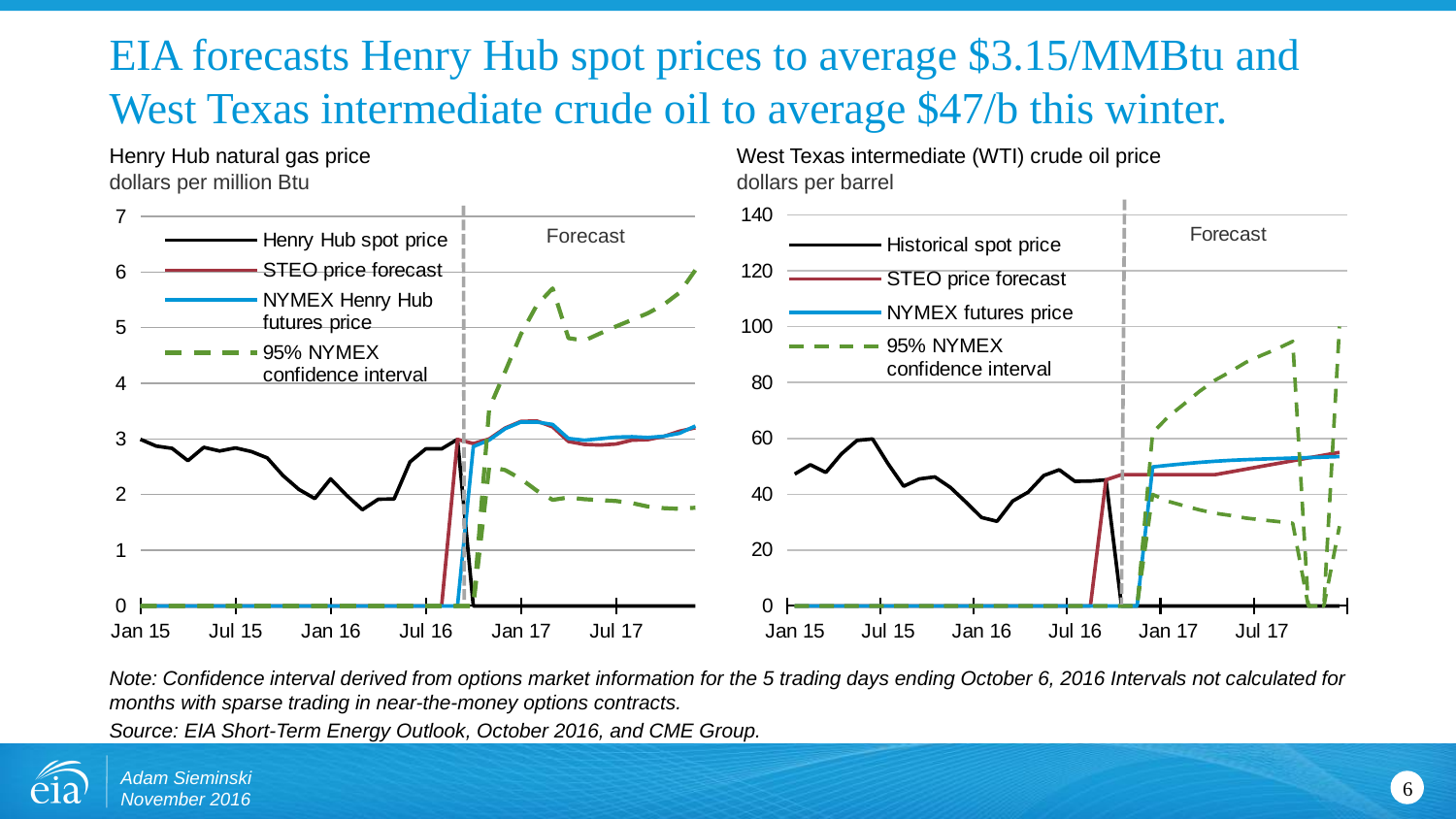
In the Henry Hub natural gas price chart, is the peak of the upper 95% NYMEX confidence interval in early 2017 greater or less than 5? greater How many series does the legend of the Henry Hub natural gas price chart list? 4 In the Henry Hub natural gas price chart, is the NYMEX Henry Hub futures price at Jan 17 greater or less than 3? greater What kind of chart is the Henry Hub natural gas price chart on the left? line chart How many series does the legend of the West Texas intermediate (WTI) crude oil price chart list? 4 In the West Texas intermediate (WTI) crude oil price chart, is the historical spot price at Jan 16 greater or less than 40? less In the West Texas intermediate (WTI) crude oil price chart, what label appears to the right of the dashed vertical line? Forecast In the Henry Hub natural gas price chart, what unit is shown under the chart title? dollars per million Btu In the West Texas intermediate (WTI) crude oil price chart, does the historical spot price rise or fall between Jul 15 and Jan 16? fall